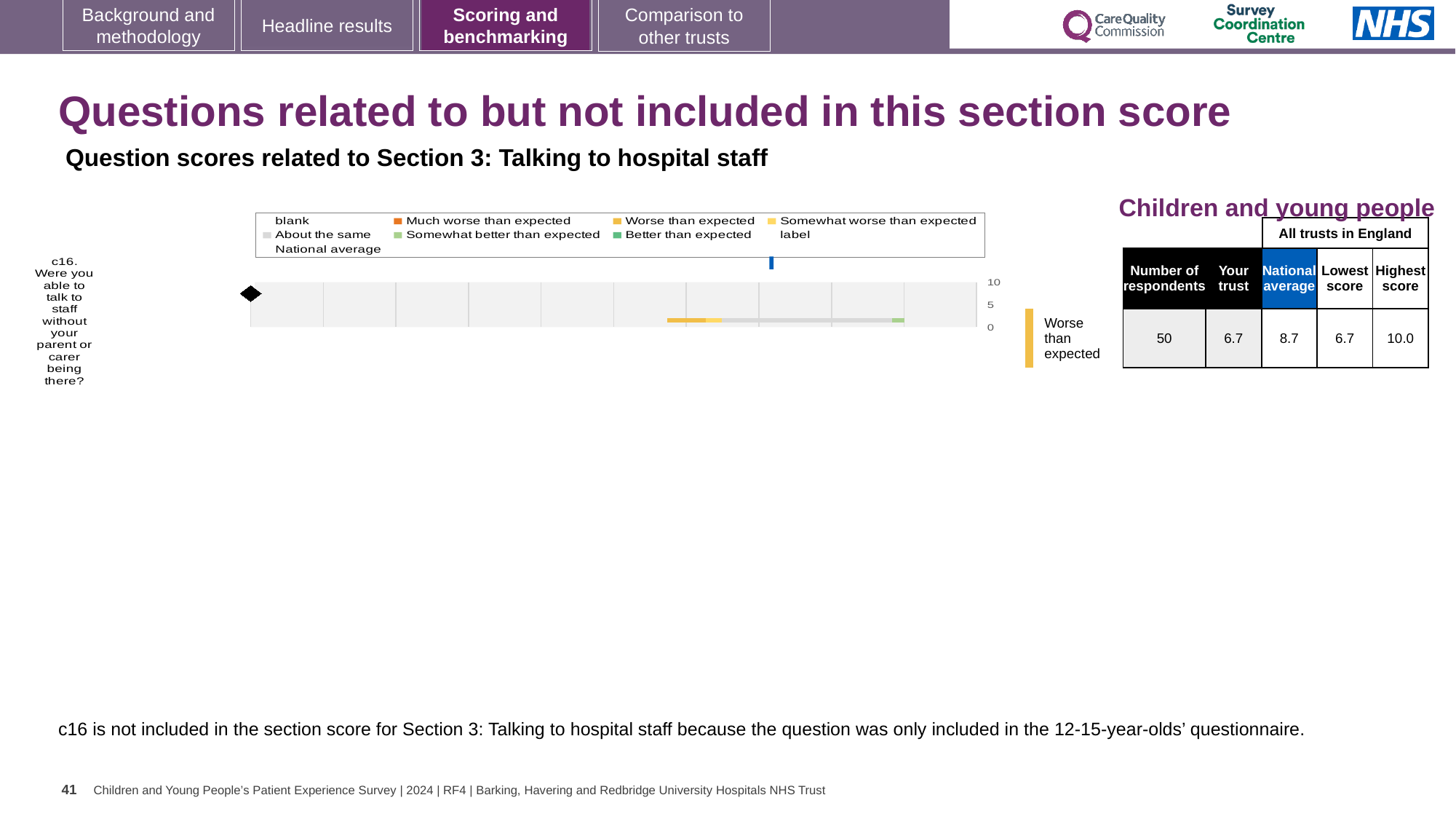
What kind of chart is shown on the slide for question c16? bar chart Which is larger for c16, the 'Your trust' score or the national average? National average Is the 'Your trust' score for c16 greater or less than 5? greater What is the lowest score among all trusts in England for c16? 6.7 What is the 'Your trust' score for c16 in the table? 6.7 Which question is plotted in the chart? c16. Were you able to talk to staff without your parent or carer being there? How many survey questions are plotted in the chart? 1 How many respondents answered c16? 50 Which benchmark category is shown for c16 next to the chart? Worse than expected What is the highest score among all trusts in England for c16? 10.0 What is the difference between the national average and the 'Your trust' score for c16? 2.0 What is the national average score for c16 in the table? 8.7